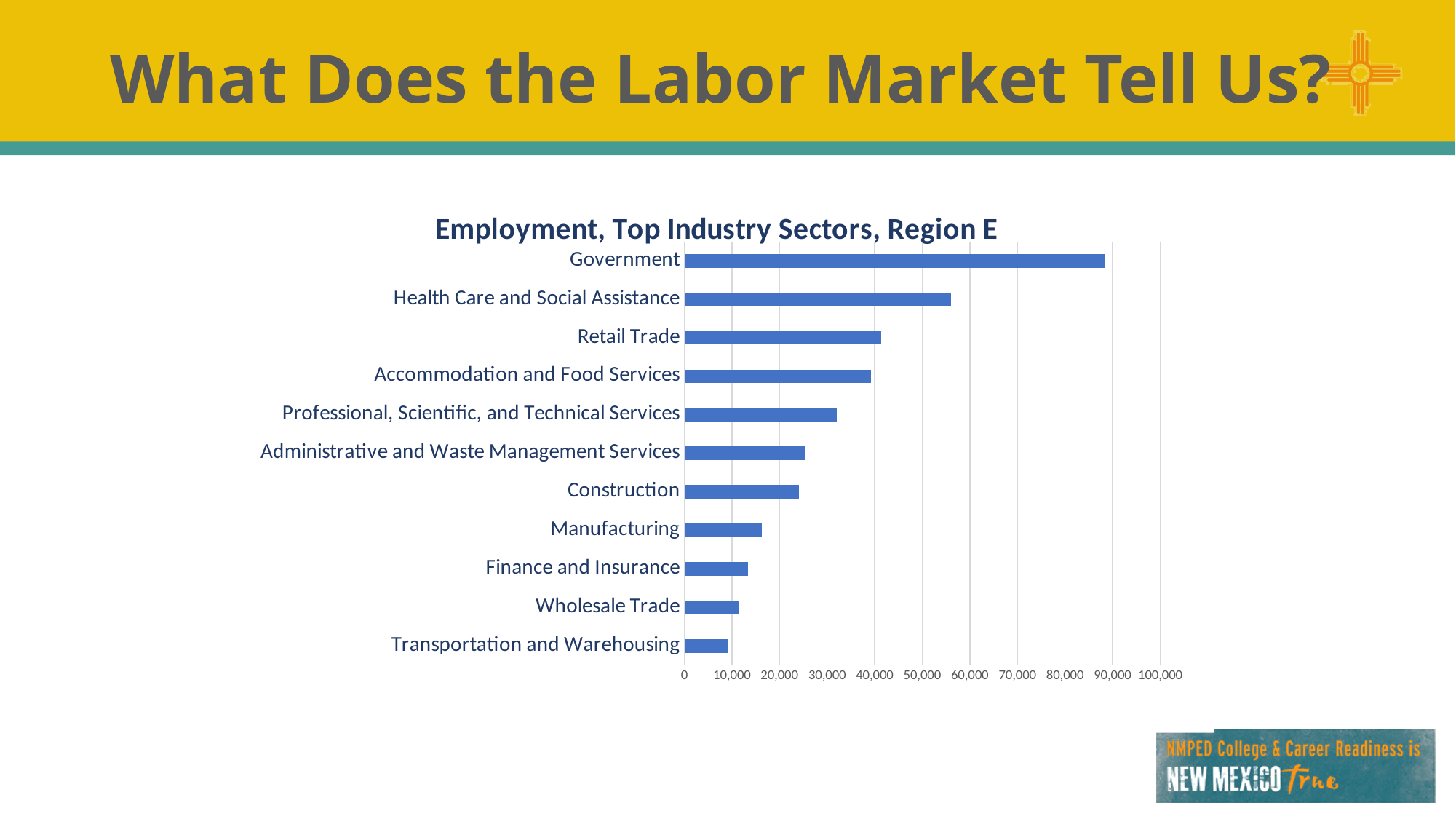
Is the value for Health Care and Social Assistance greater or less than 50,000? greater Is the value for Professional, Scientific, and Technical Services greater or less than 40,000? less Do the bar values increase or decrease from the top of the chart to the bottom? Decrease Is the value for Government greater or less than 80,000? greater Which industry sector has the highest employment? Government Which industry sector has the lowest employment? Transportation and Warehousing Which has higher employment, Manufacturing or Construction? Construction What is the title of the chart? Employment, Top Industry Sectors, Region E How many industry sectors are shown in the chart? 11 What kind of chart is shown on the slide? Bar chart Which has higher employment, Government or Health Care and Social Assistance? Government